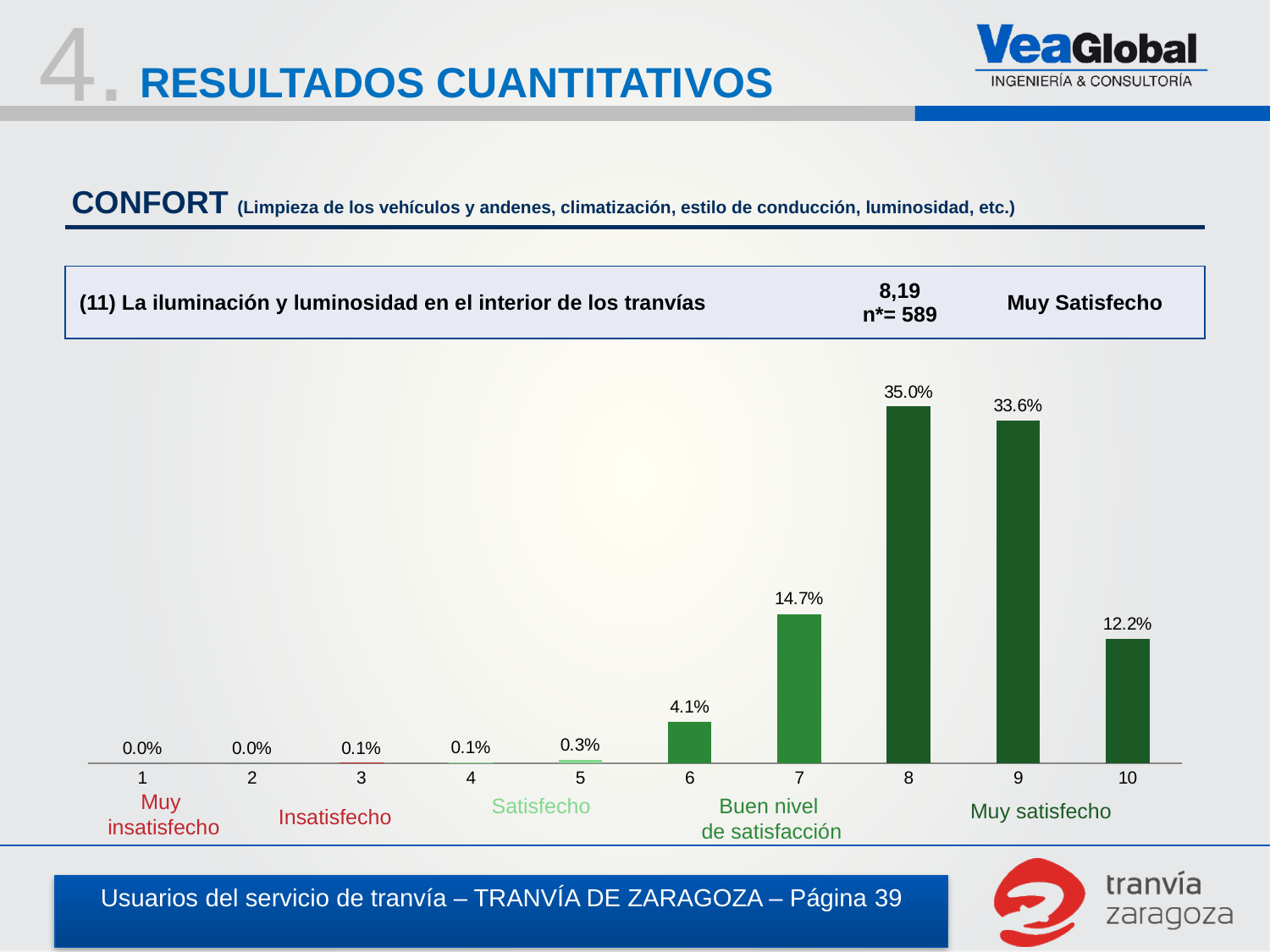
Which category has the highest value? 8 What is the value for category 5? 0.3% Do the values rise or fall from category 1 to category 8? rise What is the value for category 6? 4.1% What is the value for category 7? 14.7% What kind of chart is this? bar chart What is the value for category 9? 33.6% What is the value for category 10? 12.2% What is the difference between the values for categories 8 and 9? 1.4% How many categories are shown on the x axis? 10 What is the value for category 8? 35.0% Which is larger, the value for category 7 or the value for category 10? 7